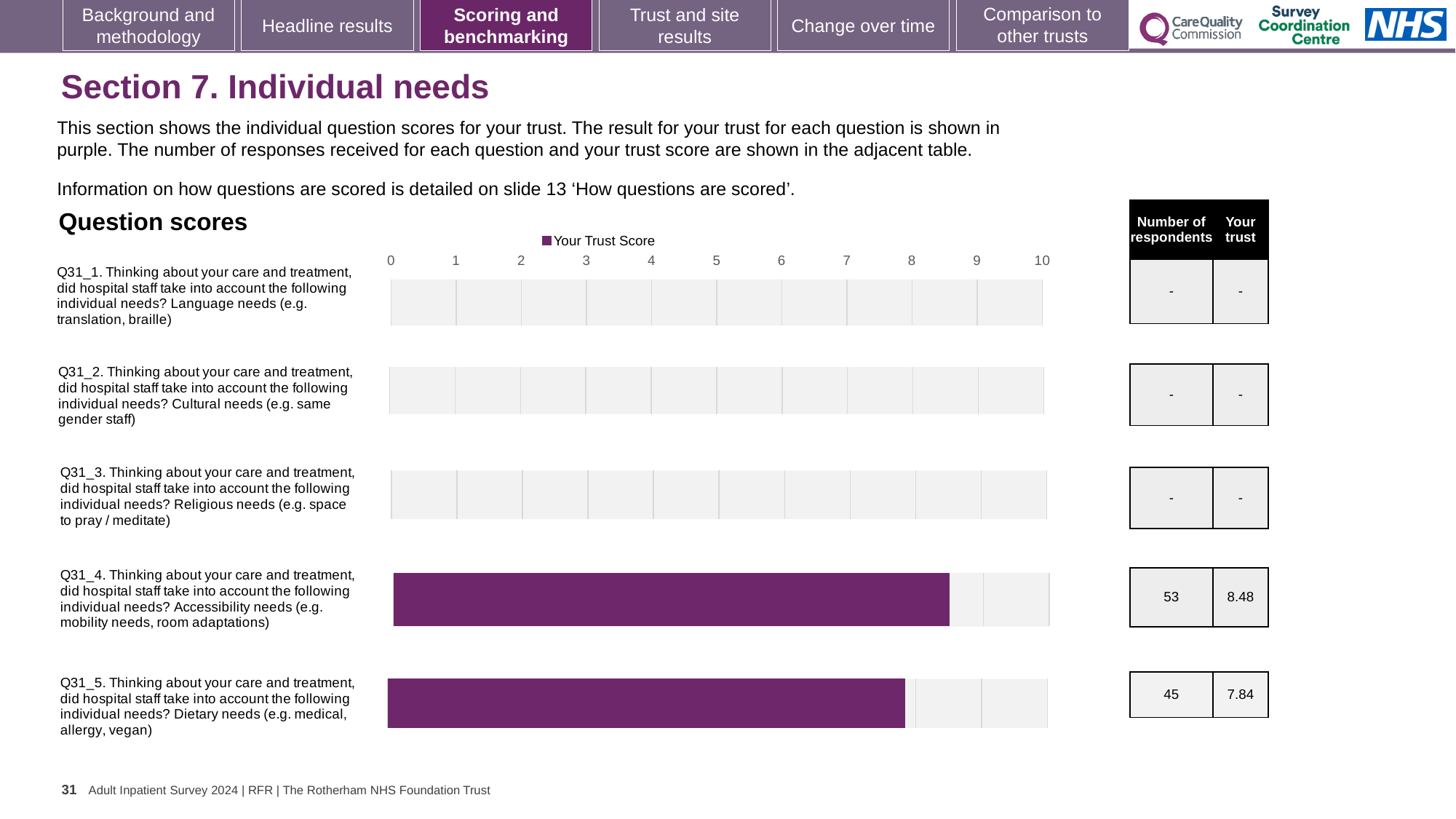
What is the difference between the trust scores for Q31_4 and Q31_5? 0.64 What is the trust score for Q31_4 (Accessibility needs)? 8.48 How many respondents answered Q31_4 (Accessibility needs)? 53 What is the trust score for Q31_5 (Dietary needs)? 7.84 What type of chart is shown on the slide? Bar chart What is the series name shown in the chart legend? Your Trust Score Which has a larger trust score, Q31_4 (Accessibility needs) or Q31_5 (Dietary needs)? Q31_4 (Accessibility needs) Is the trust score for Q31_5 (Dietary needs) greater or less than 8? less Is the trust score for Q31_4 (Accessibility needs) greater or less than 8? greater Which question has the highest trust score shown on the chart? Q31_4 (Accessibility needs) How many questions are listed on the chart? 5 How many respondents answered Q31_5 (Dietary needs)? 45